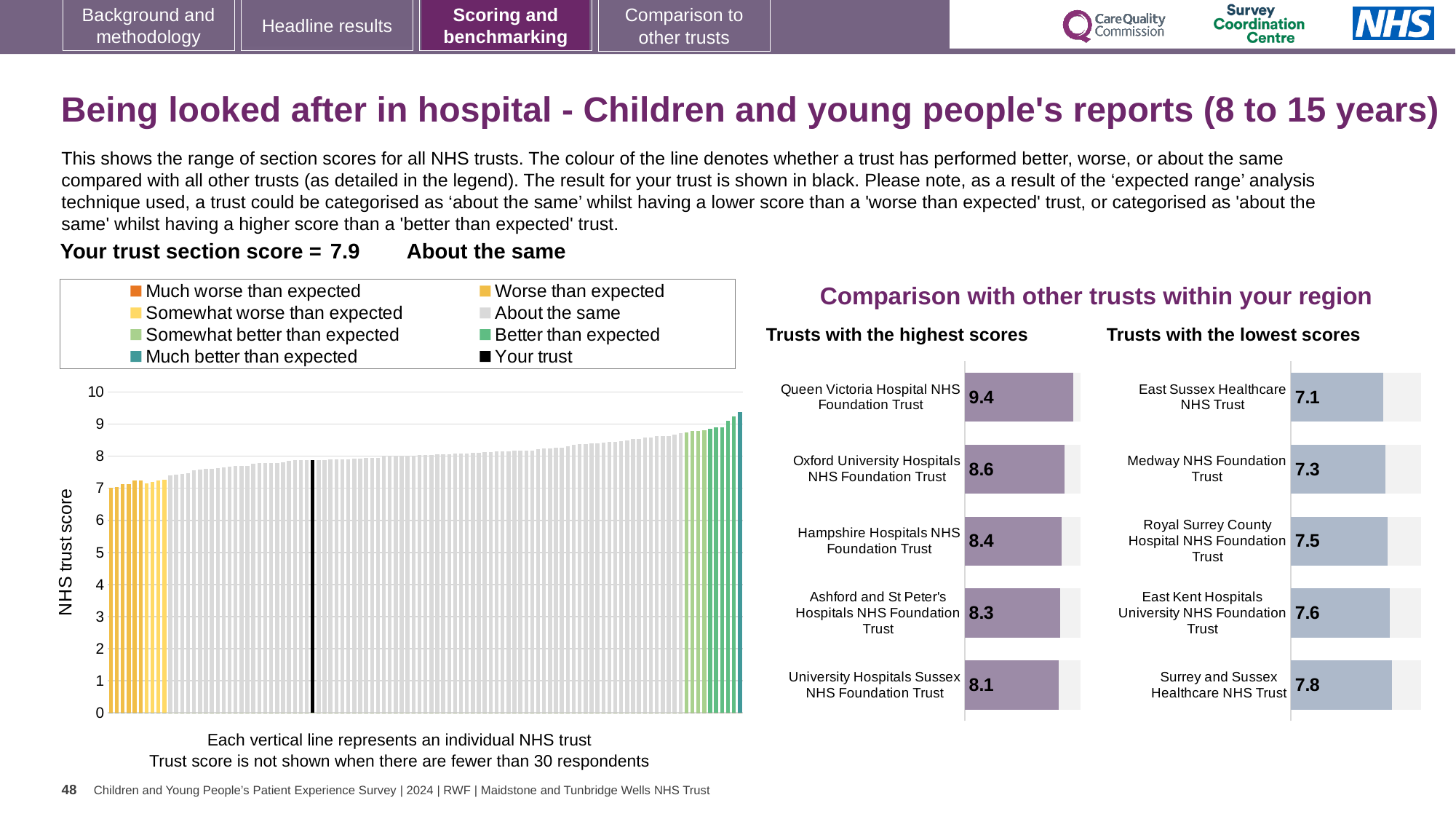
In the 'Trusts with the highest scores' chart, which has the higher score: Hampshire Hospitals NHS Foundation Trust or Ashford and St Peter's Hospitals NHS Foundation Trust? Hampshire Hospitals NHS Foundation Trust In the main NHS trust score chart, is the value for your trust (the black line) greater or less than 7? greater In the 'Trusts with the lowest scores' chart, which trust has the lowest score? East Sussex Healthcare NHS Trust How many entries does the legend of the main NHS trust score chart list? 8 What kind of chart is the 'Trusts with the highest scores' chart? Bar chart In the 'Trusts with the highest scores' chart, which trust has the lowest score shown? University Hospitals Sussex NHS Foundation Trust In the 'Trusts with the lowest scores' chart, what is the score for Medway NHS Foundation Trust? 7.3 In the main NHS trust score chart, do the values rise or fall from left to right? Rise In the 'Trusts with the highest scores' chart, what is the score for Queen Victoria Hospital NHS Foundation Trust? 9.4 In the 'Trusts with the highest scores' chart, what is the difference between the scores of Queen Victoria Hospital NHS Foundation Trust and Oxford University Hospitals NHS Foundation Trust? 0.8 How many trusts are listed in the 'Trusts with the lowest scores' chart? 5 In the 'Trusts with the lowest scores' chart, what is the difference between the scores of Surrey and Sussex Healthcare NHS Trust and East Sussex Healthcare NHS Trust? 0.7